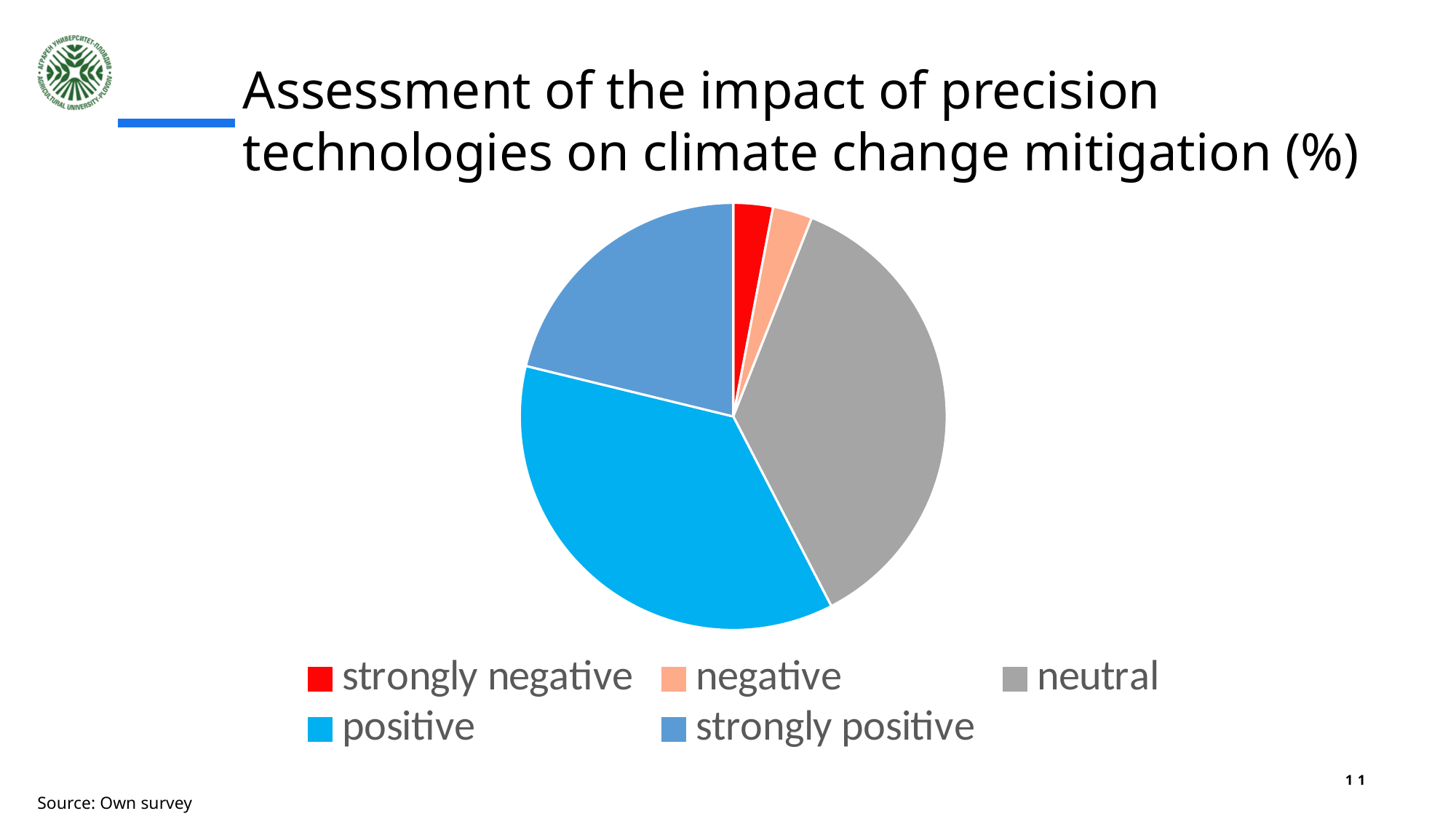
How many categories does the pie chart show? 5 What colour represents the neutral category in the pie chart? grey What is the title of the chart? Assessment of the impact of precision technologies on climate change mitigation (%) Which slice is larger, strongly positive or negative? strongly positive What kind of chart is shown on the slide? pie chart Which slice is larger, neutral or strongly positive? neutral How many entries does the legend list? 5 Which slice is larger, positive or strongly positive? positive